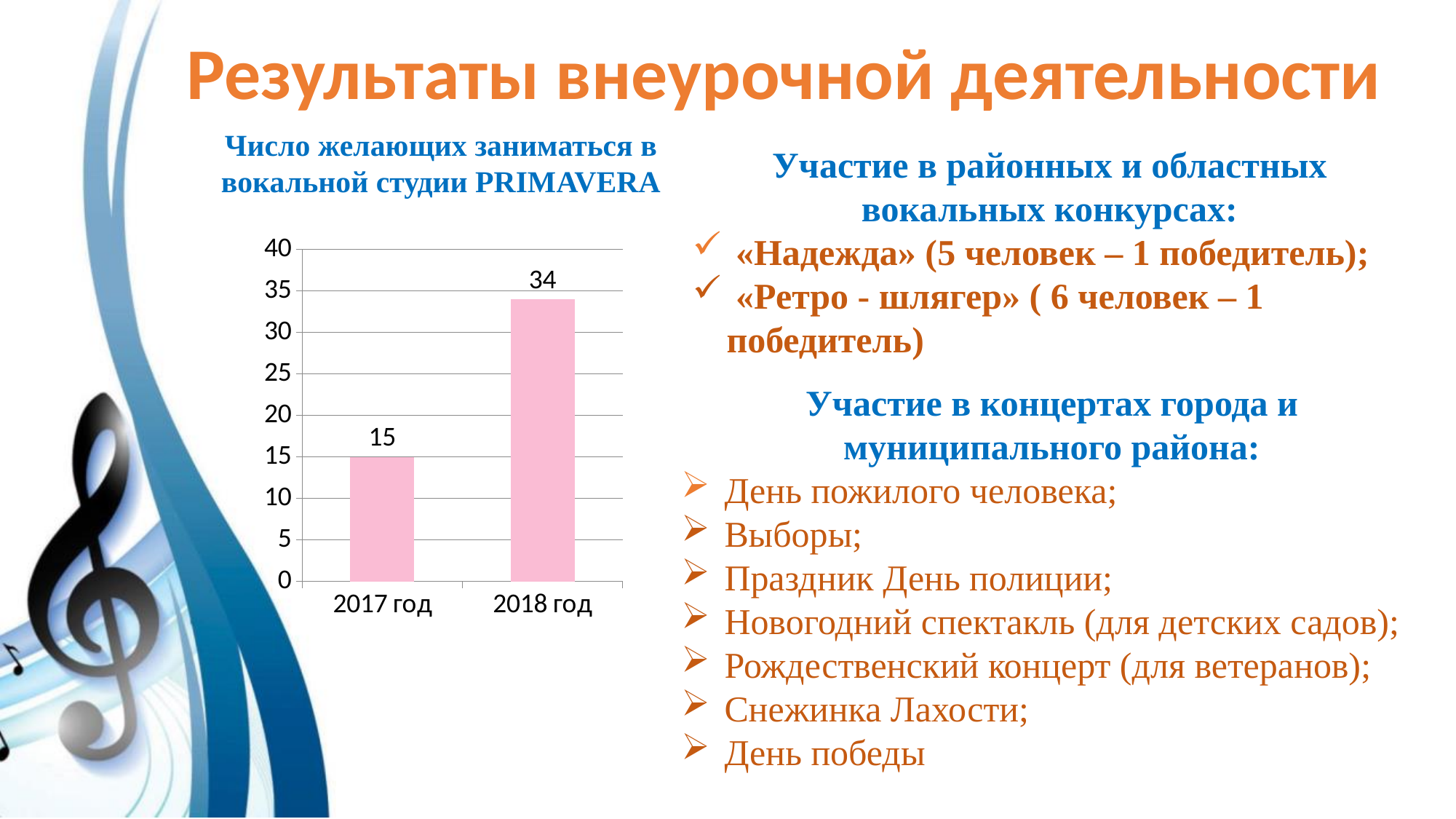
Is the value for 2017 год greater or less than 20? less What is the value for 2018 год? 34 Is the value for 2018 год greater or less than 30? greater What is the value for 2017 год? 15 Which year has the lowest value? 2017 год How many categories are shown on the x axis of the chart? 2 What kind of chart is shown on the slide? bar chart Which year has the highest value? 2018 год Do the values rise or fall from 2017 год to 2018 год? rise What is the difference between the values for 2018 год and 2017 год? 19 Which is larger, the value for 2017 год or the value for 2018 год? 2018 год What is the title of the chart? Число желающих заниматься в вокальной студии PRIMAVERA